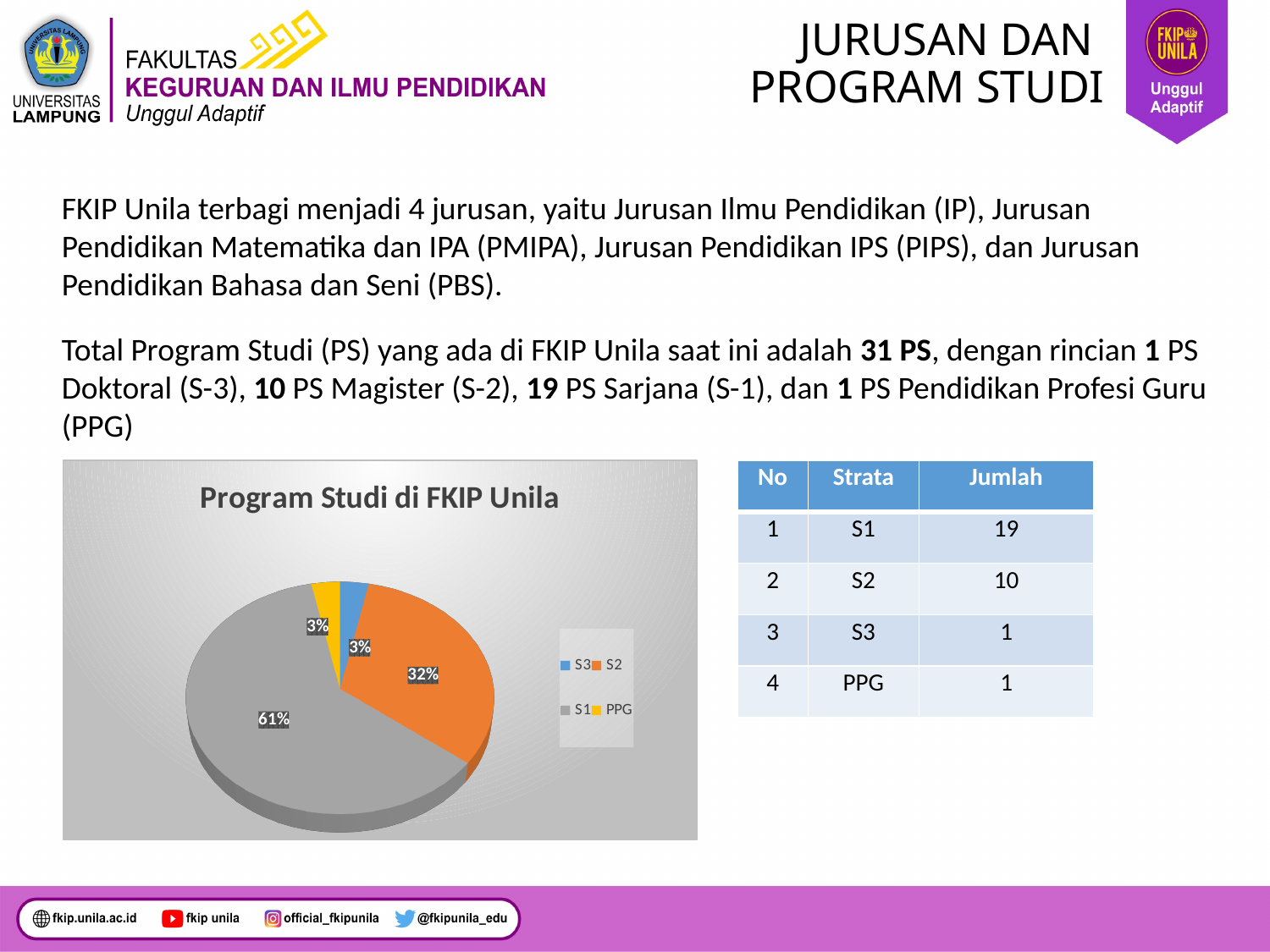
What type of chart is shown on the slide? pie chart What share of the pie does S2 represent? 32% What share of the pie does PPG represent? 3% What share of the pie does S3 represent? 3% What share of the pie does S1 represent? 61% What colour is the S1 slice in the pie chart? gray What is the title of the chart? Program Studi di FKIP Unila What is the difference in percentage points between the S1 slice and the S2 slice? 29 Which category has the largest slice of the pie? S1 Which is larger, the slice for S2 or the slice for S1? S1 How many entries does the legend list? 4 How many slices does the pie chart have? 4